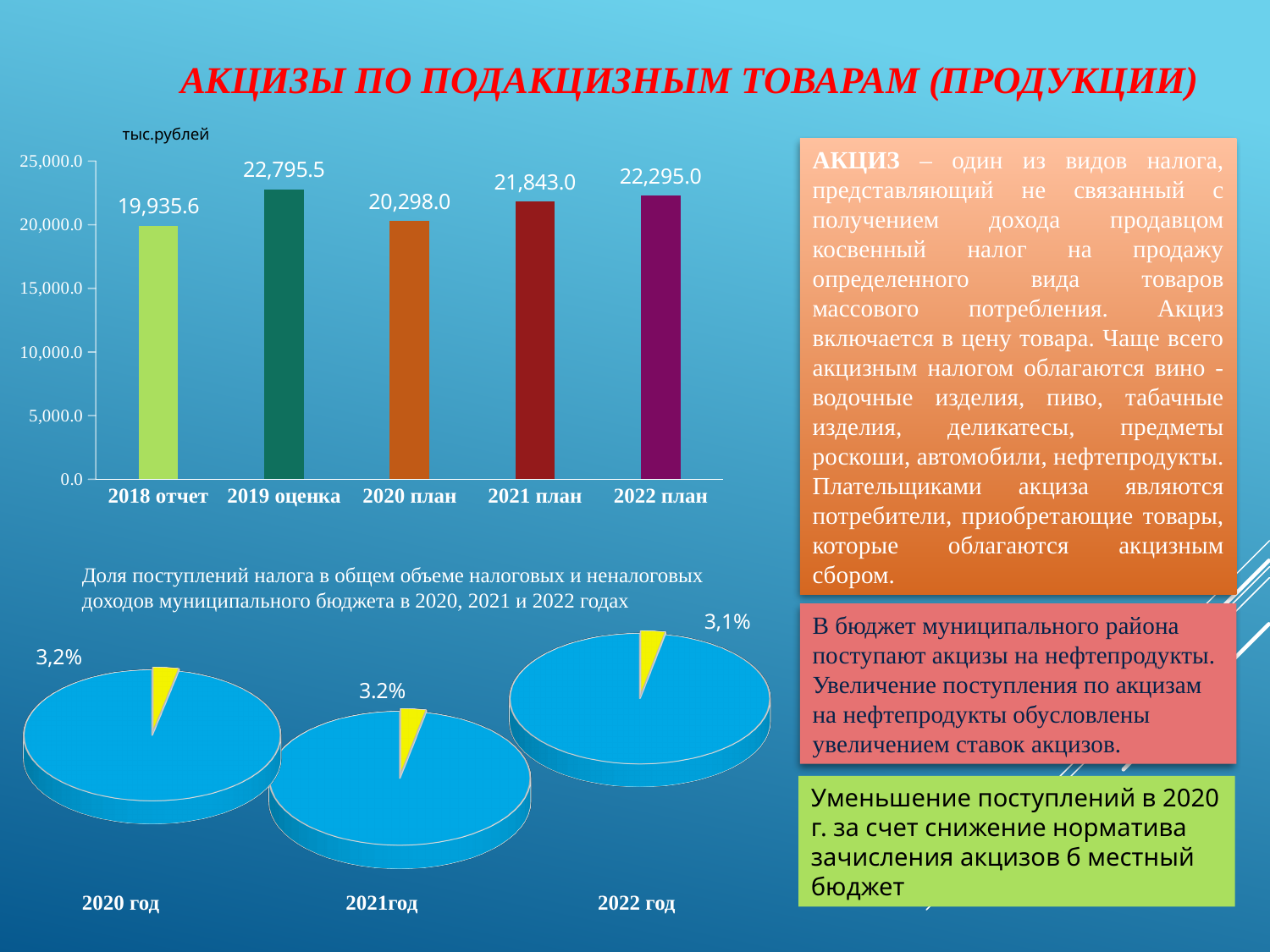
In the bar chart, which is larger: the value for 2020 план or the value for 2021 план? 2021 план In the pie chart for 2020 год, what share does the yellow slice represent? 3,2% In the bar chart, which category has the lowest value? 2018 отчет How many categories are shown in the bar chart? 5 What kind of chart is the top chart on the slide? bar chart In the bar chart, what is the difference between the values for 2019 оценка and 2018 отчет? 2,859.9 In the bar chart, what is the value for 2021 план? 21,843.0 In the bar chart, what is the difference between the values for 2022 план and 2021 план? 452.0 In the bar chart, what is the value for 2018 отчет? 19,935.6 In the bar chart, which category has the highest value? 2019 оценка In the bar chart, is the value for 2020 план greater or less than 15,000.0? greater In the pie chart for 2022 год, what share does the yellow slice represent? 3,1%